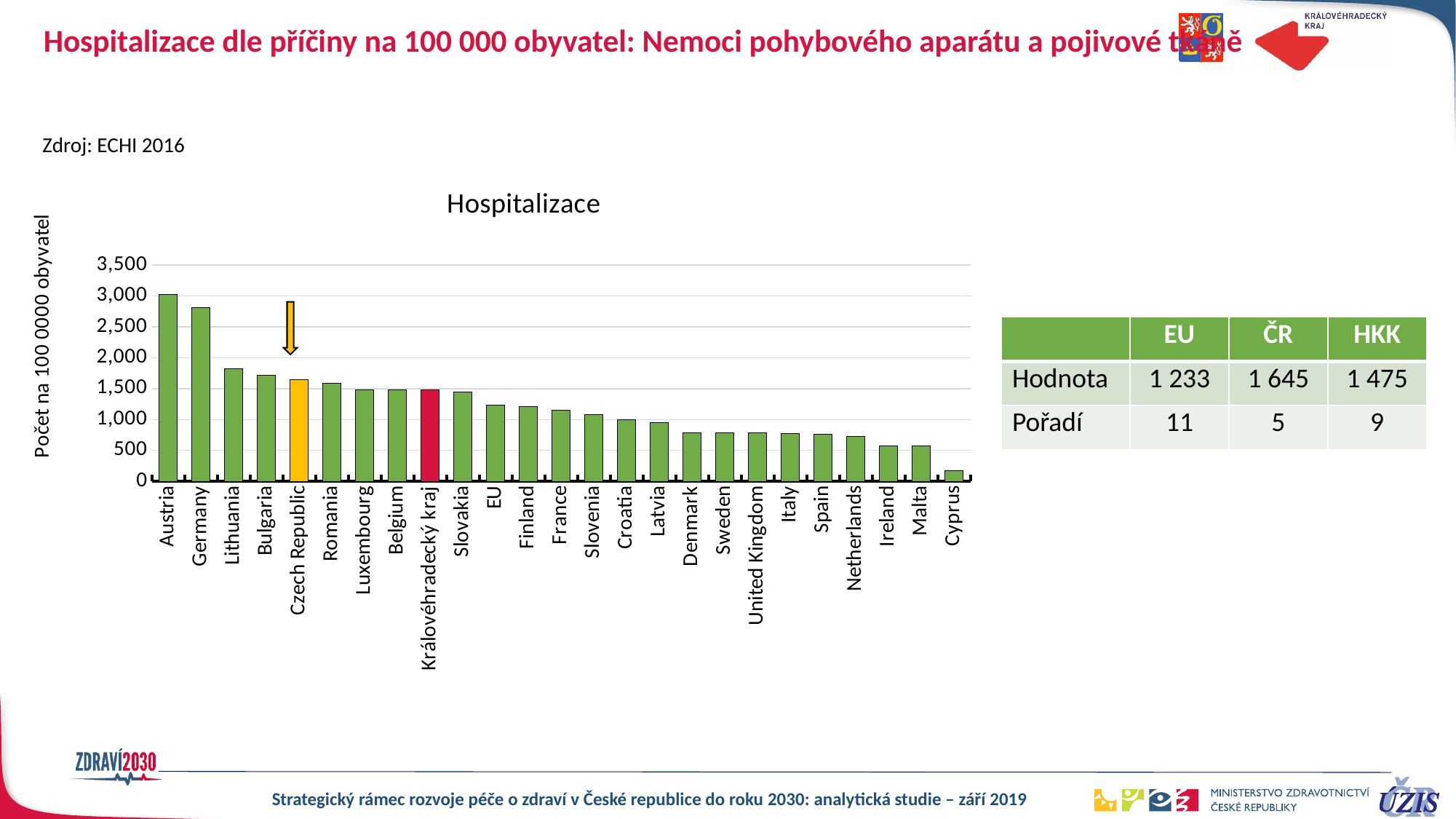
What is the difference between the value for ČR and the value for HKK shown in the table? 170 How many categories are plotted on the x axis of the chart? 25 Is the value for Austria greater or less than 2,500? greater What is the value for the Czech Republic (ČR) according to the table on the slide? 1 645 What is the title of the chart? Hospitalizace What kind of chart is shown on the slide? bar chart Which category has the lowest value in the chart? Cyprus Which category has the highest value in the chart? Austria Which is larger, the value for Czech Republic or the value for Královéhradecký kraj? Czech Republic Do the values rise or fall moving from left to right along the x axis? fall What is the value for Královéhradecký kraj (HKK) according to the table on the slide? 1 475 What is the value for the EU according to the table on the slide? 1 233